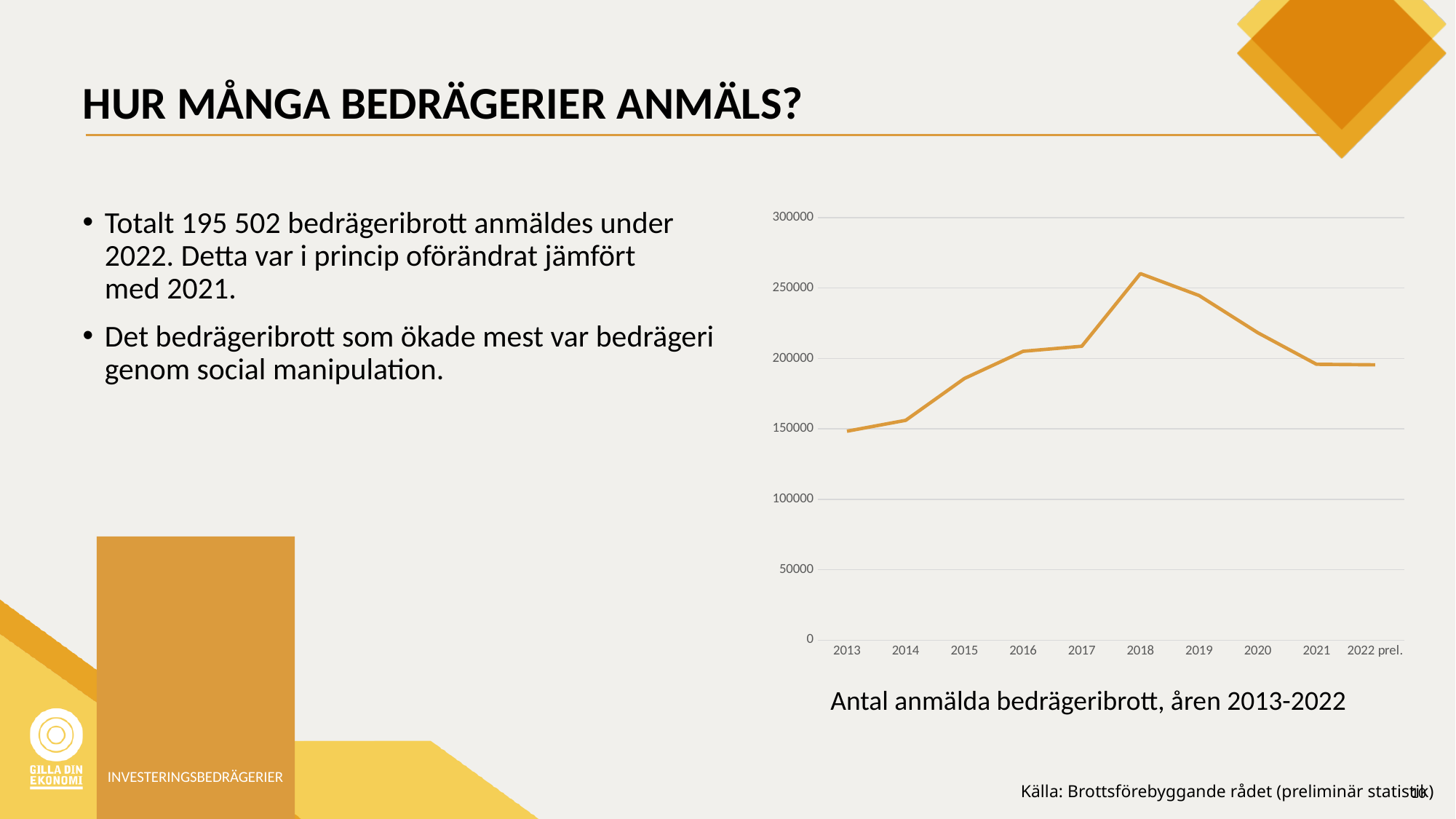
Is the value for 2015 greater or less than 200000? less How many years are plotted on the x axis of the chart? 10 Do the values rise or fall from 2018 to 2021? fall Is the value for 2020 greater or less than 200000? greater Which year has the lowest number of reported fraud offences in the chart? 2013 What kind of chart is shown on the slide? line chart Which year has the larger value, 2019 or 2021? 2019 Do the values rise or fall from 2013 to 2018? rise What is the caption printed below the chart? Antal anmälda bedrägeribrott, åren 2013-2022 Which year has the highest number of reported fraud offences in the chart? 2018 Is the value for 2018 greater or less than 250000? greater